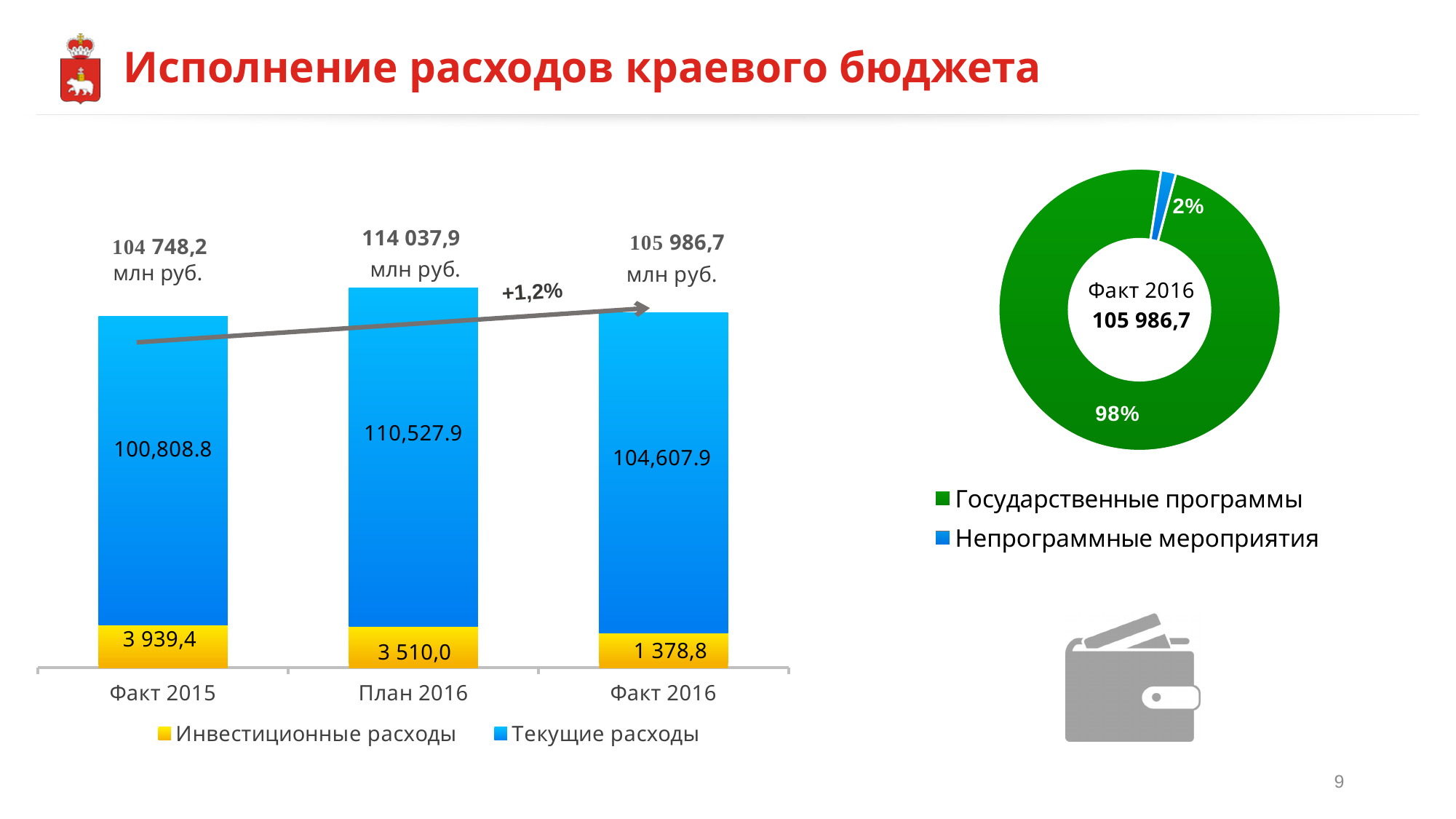
In the bar chart on the left, what is the value of Текущие расходы for План 2016? 110,527.9 In the bar chart on the left, what is the difference between Инвестиционные расходы for Факт 2015 and Факт 2016? 2 560,6 In the bar chart on the left, is Текущие расходы larger for Факт 2016 or for Факт 2015? Факт 2016 What kind of chart is the chart on the left? Stacked bar chart In the bar chart on the left, which category has the lowest value of Инвестиционные расходы? Факт 2016 In the bar chart on the left, which category has the highest value of Текущие расходы? План 2016 In the pie chart on the right, what share does Непрограммные мероприятия have? 2% In the pie chart on the right, which slice is the largest? Государственные программы In the bar chart on the left, what is the total shown above the Факт 2015 bar? 104 748,2 млн руб. In the bar chart on the left, what is the value of Инвестиционные расходы for Факт 2016? 1 378,8 How many categories are shown on the x axis of the bar chart on the left? 3 How many series does the legend of the bar chart on the left list? 2